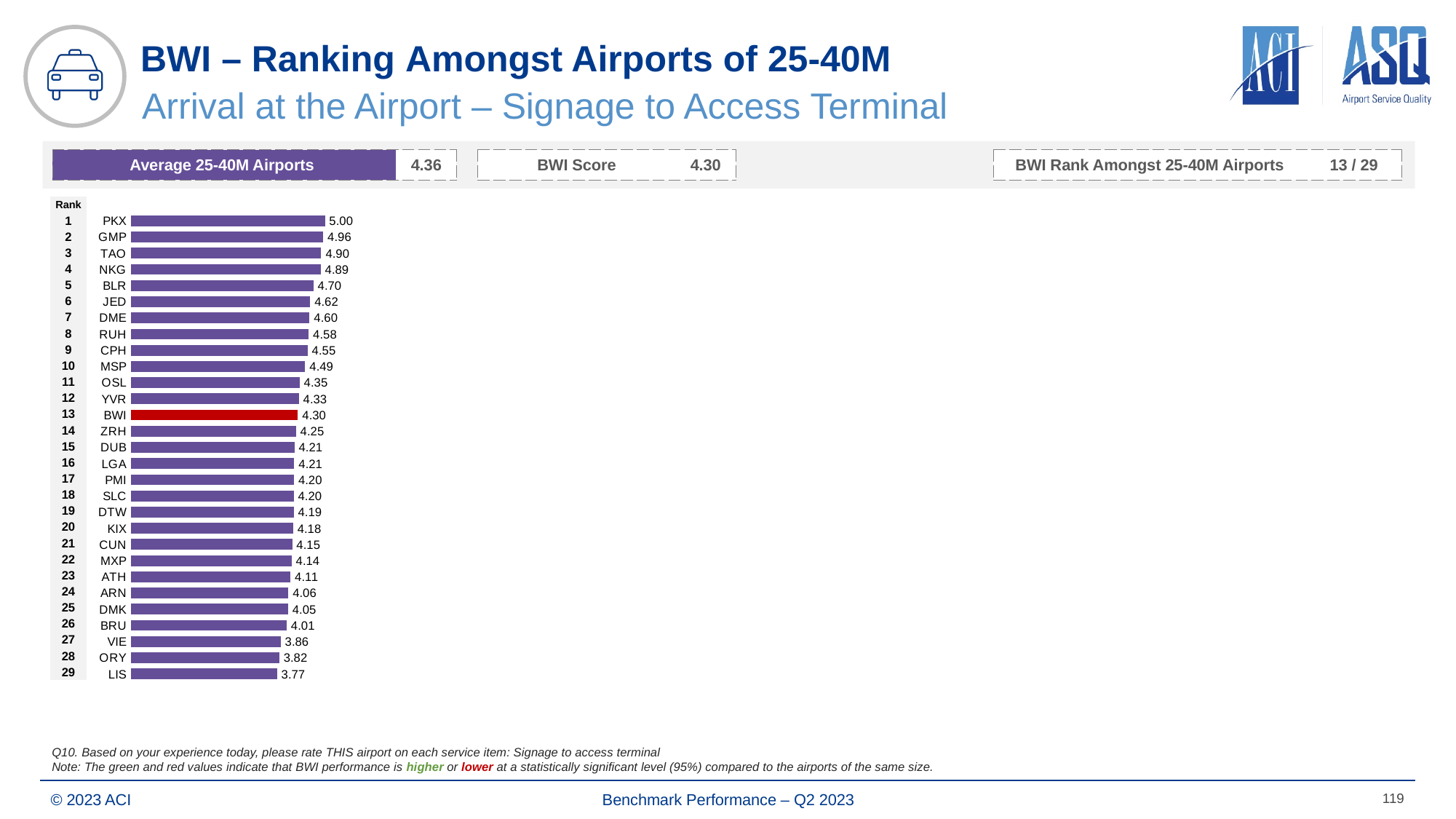
Which airport has the lowest value in the chart? LIS How many airports are shown in the chart? 29 Which has a larger value, MSP or ZRH? MSP What rank does BWI hold in the chart? 13 What is the value for PKX in the chart? 5.00 What is the value for LIS in the chart? 3.77 What is the difference between the values for BWI and LIS? 0.53 What kind of chart is shown on the slide? Bar chart What is the value for BWI in the chart? 4.30 Which bar in the chart is coloured red? BWI What is the difference between the values for PKX and BWI? 0.70 Which airport has the highest value in the chart? PKX